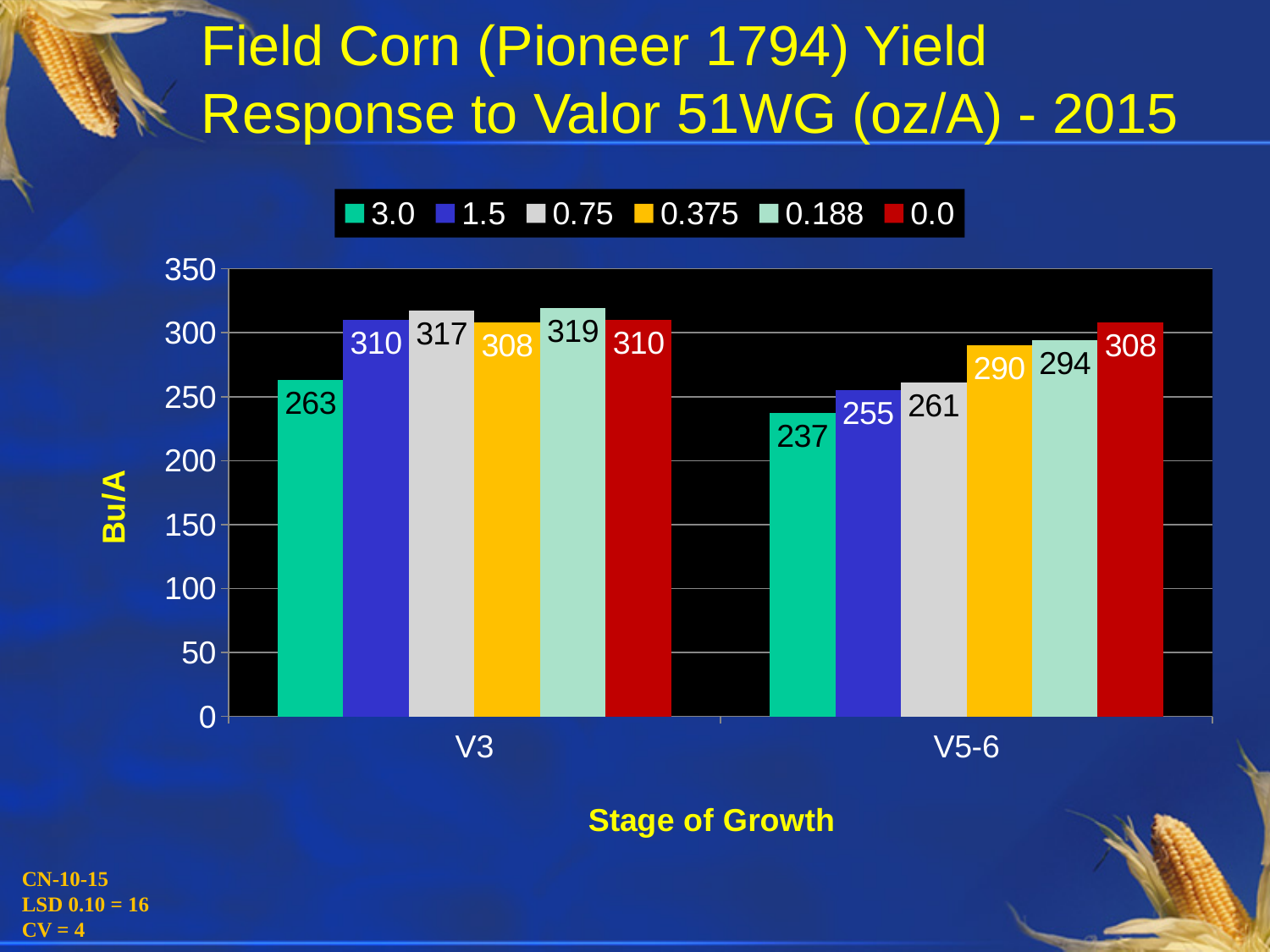
What is the yield (Bu/A) for the 3.0 oz/A rate at the V3 stage? 263 Which is larger: the yield for the 1.5 rate at V3 or the yield for the 1.5 rate at V5-6? V3 What is the yield (Bu/A) for the 0.375 oz/A rate at the V5-6 stage? 290 Which rate has the highest yield at the V3 stage? 0.188 How many stage-of-growth categories are shown on the x axis? 2 What is the yield (Bu/A) for the 0.0 oz/A rate at the V5-6 stage? 308 What is the difference in yield for the 3.0 rate between the V3 and V5-6 stages? 26 Which rate has the lowest yield at the V5-6 stage? 3.0 What type of chart is shown on the slide? bar chart What is the difference in yield between the 0.188 rate and the 3.0 rate at the V3 stage? 56 Is the yield for the 0.75 rate at the V5-6 stage greater or less than 300? less How many series does the legend list? 6